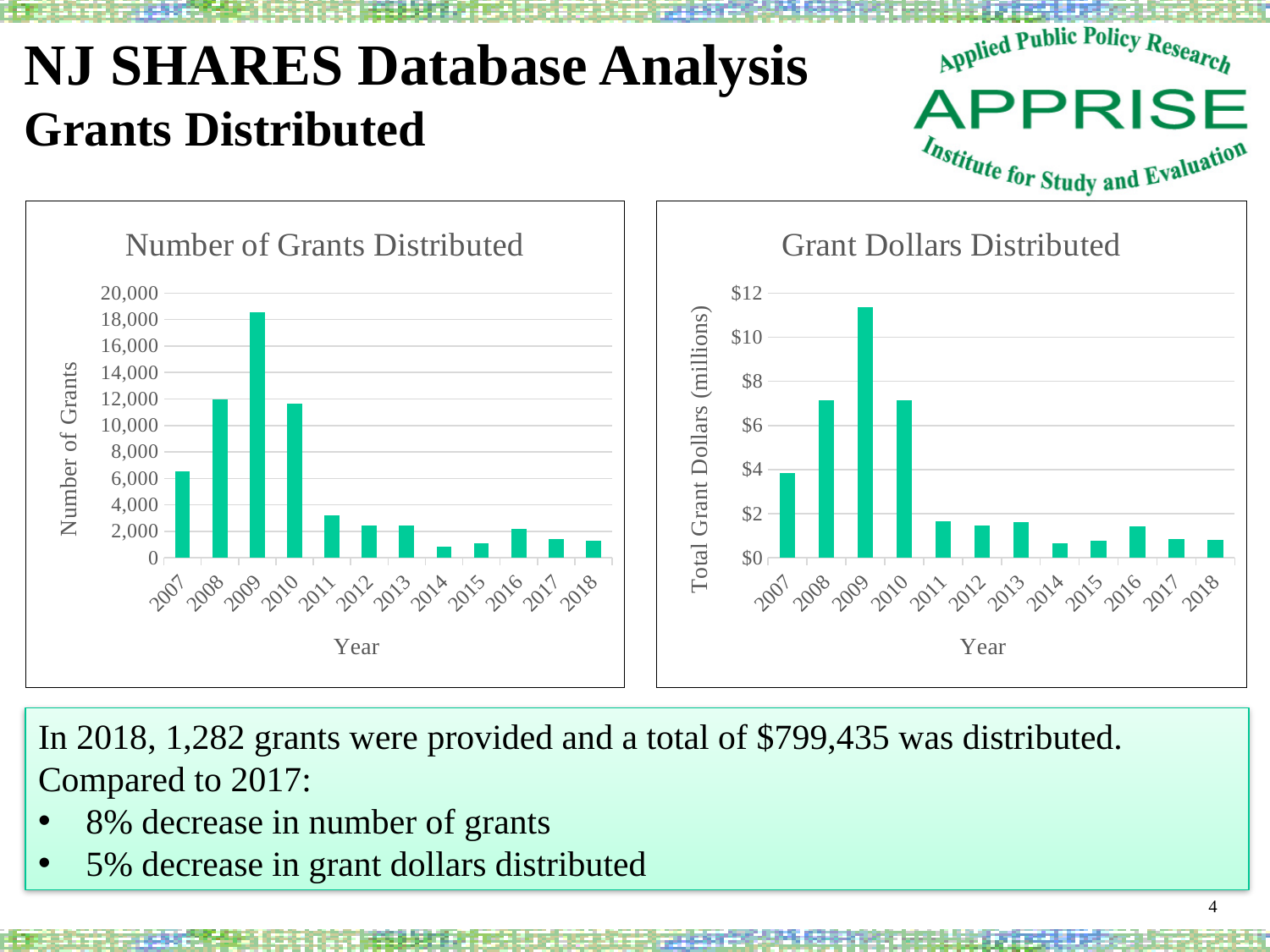
In the "Grant Dollars Distributed" chart, is the value for 2011 greater or less than $2? less In the "Grant Dollars Distributed" chart, do the values rise or fall from 2009 to 2014? fall In the "Number of Grants Distributed" chart, is the value for 2014 greater or less than 2,000? less In the "Grant Dollars Distributed" chart, which year has the highest total grant dollars? 2009 In the "Number of Grants Distributed" chart, which year has the highest number of grants? 2009 How many years are shown on the x axis of the "Grant Dollars Distributed" chart? 12 What type of chart is the "Number of Grants Distributed" chart? bar chart In the "Number of Grants Distributed" chart, which year has the lowest number of grants? 2014 In the "Grant Dollars Distributed" chart, is the value for 2009 greater or less than $10? greater What is the y-axis title of the "Grant Dollars Distributed" chart? Total Grant Dollars (millions) In the "Number of Grants Distributed" chart, which year has more grants, 2008 or 2011? 2008